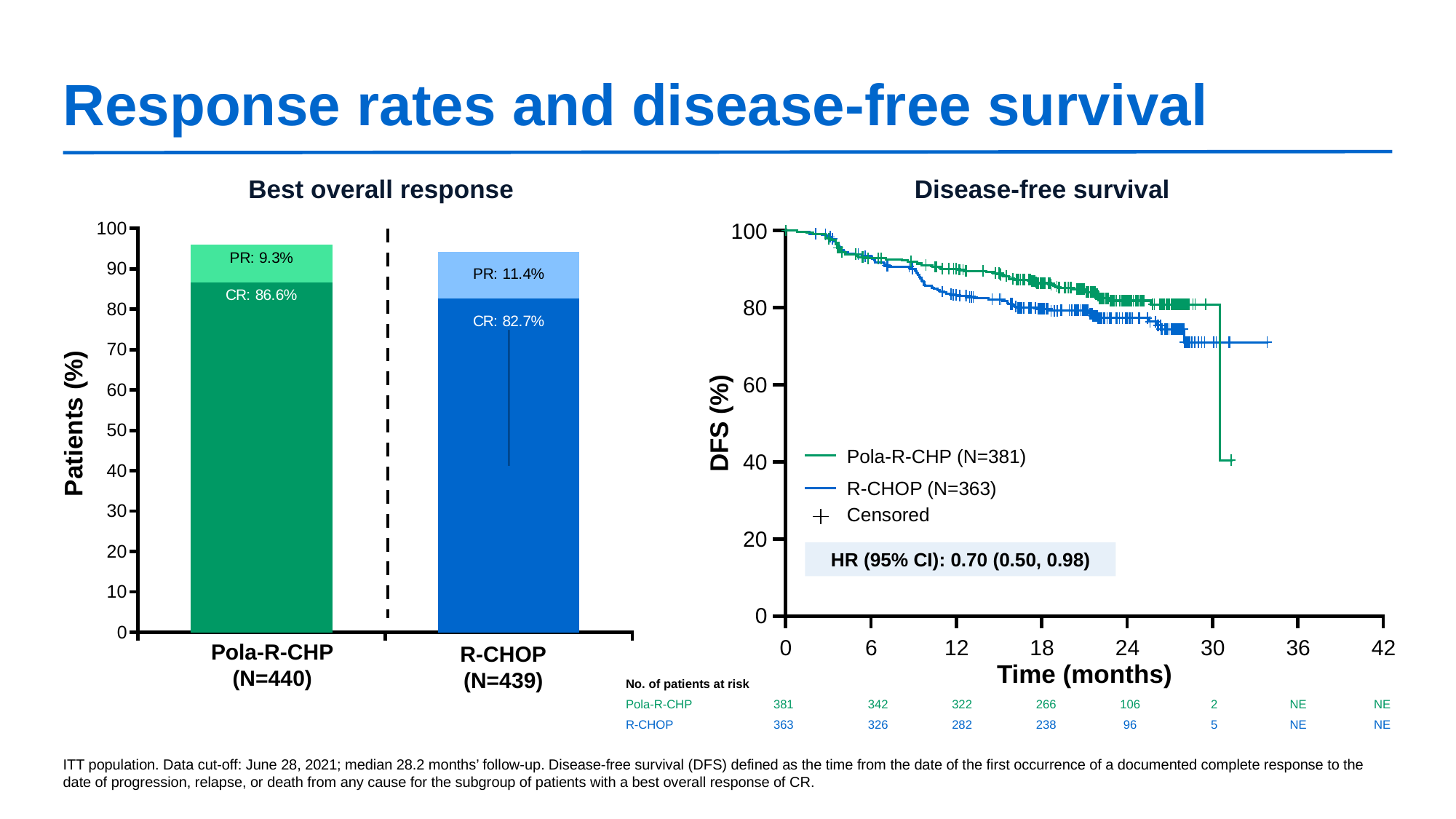
In the Disease-free survival chart, what is the hazard ratio with 95% CI shown? 0.70 (0.50, 0.98) In the Best overall response chart, what is the PR rate for R-CHOP? 11.4% In the Disease-free survival chart, do the DFS curves rise or fall as time increases? fall In the Best overall response chart, what is the difference between the CR rates of Pola-R-CHP and R-CHOP? 3.9 percentage points In the Best overall response chart, what is the CR rate for R-CHOP? 82.7% In the Disease-free survival chart, how many R-CHOP patients were at risk at 18 months? 238 In the Disease-free survival chart, how many series does the legend list, excluding the Censored marker? 2 In the Disease-free survival chart, is the DFS value for R-CHOP at 24 months greater or less than 80? less In the Best overall response chart, which arm has the higher CR rate? Pola-R-CHP In the Best overall response chart, what is the CR rate for Pola-R-CHP? 86.6% In the Best overall response chart, what is the total of the CR and PR segments for the Pola-R-CHP bar? 95.9% What kind of chart is the Best overall response chart? Stacked bar chart